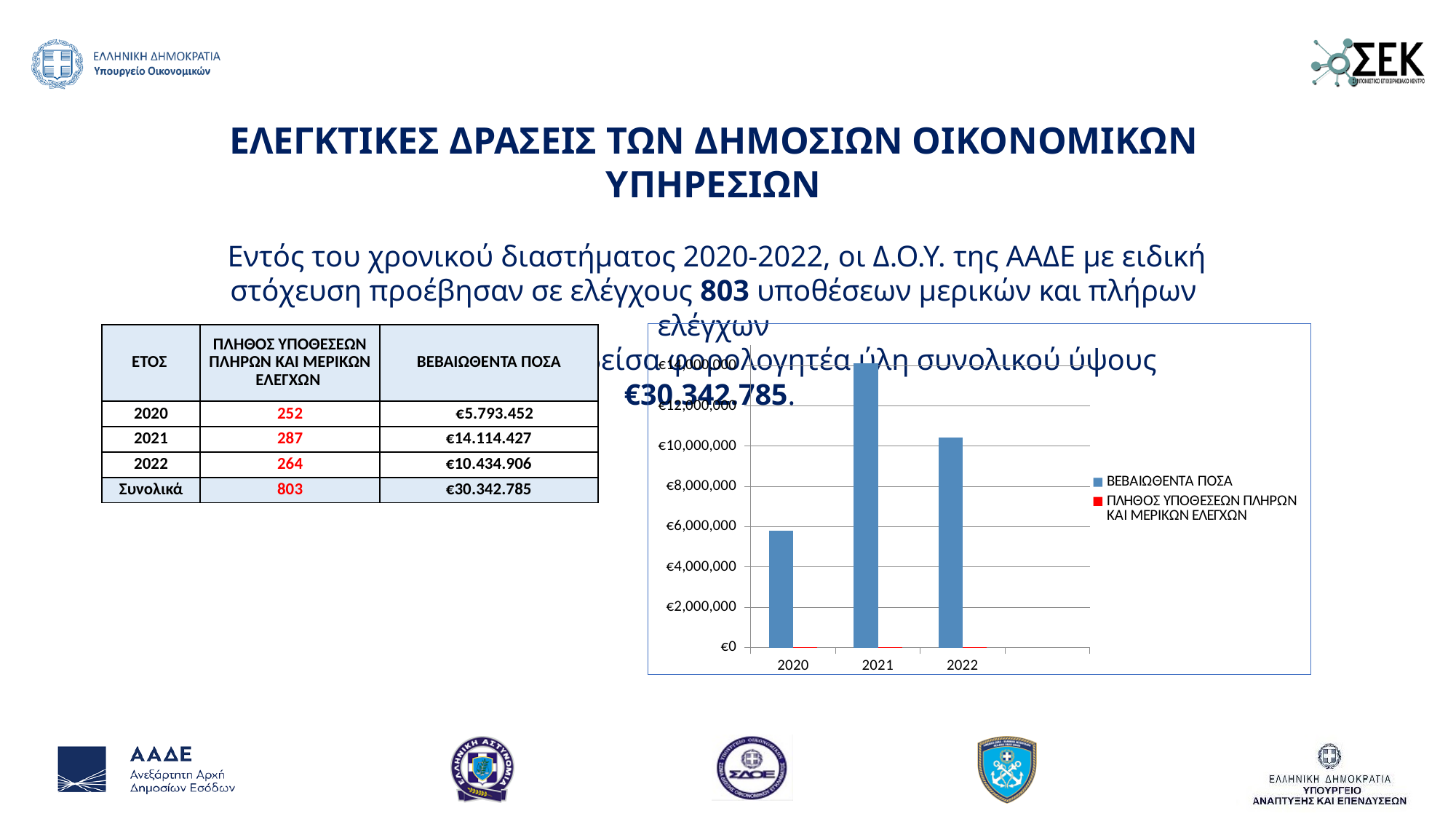
In the chart, is the ΒΕΒΑΙΩΘΕΝΤΑ ΠΟΣΑ bar for 2022 taller or shorter than the bar for 2020? taller Is the ΒΕΒΑΙΩΘΕΝΤΑ ΠΟΣΑ value for 2020 greater or less than €4,000,000? greater How many series does the chart legend list? 2 What kind of chart is shown on the slide? bar chart What is the highest value labelled on the chart's y axis? €14,000,000 Which year has the shortest ΒΕΒΑΙΩΘΕΝΤΑ ΠΟΣΑ bar in the chart? 2020 Is the ΒΕΒΑΙΩΘΕΝΤΑ ΠΟΣΑ value for 2022 greater or less than €12,000,000? less Which year has the tallest ΒΕΒΑΙΩΘΕΝΤΑ ΠΟΣΑ bar in the chart? 2021 Is the ΒΕΒΑΙΩΘΕΝΤΑ ΠΟΣΑ value for 2021 greater or less than €12,000,000? greater How many years are shown on the x axis of the chart? 3 Does the ΒΕΒΑΙΩΘΕΝΤΑ ΠΟΣΑ value rise or fall from 2021 to 2022? fall What colour are the ΒΕΒΑΙΩΘΕΝΤΑ ΠΟΣΑ bars in the chart? blue